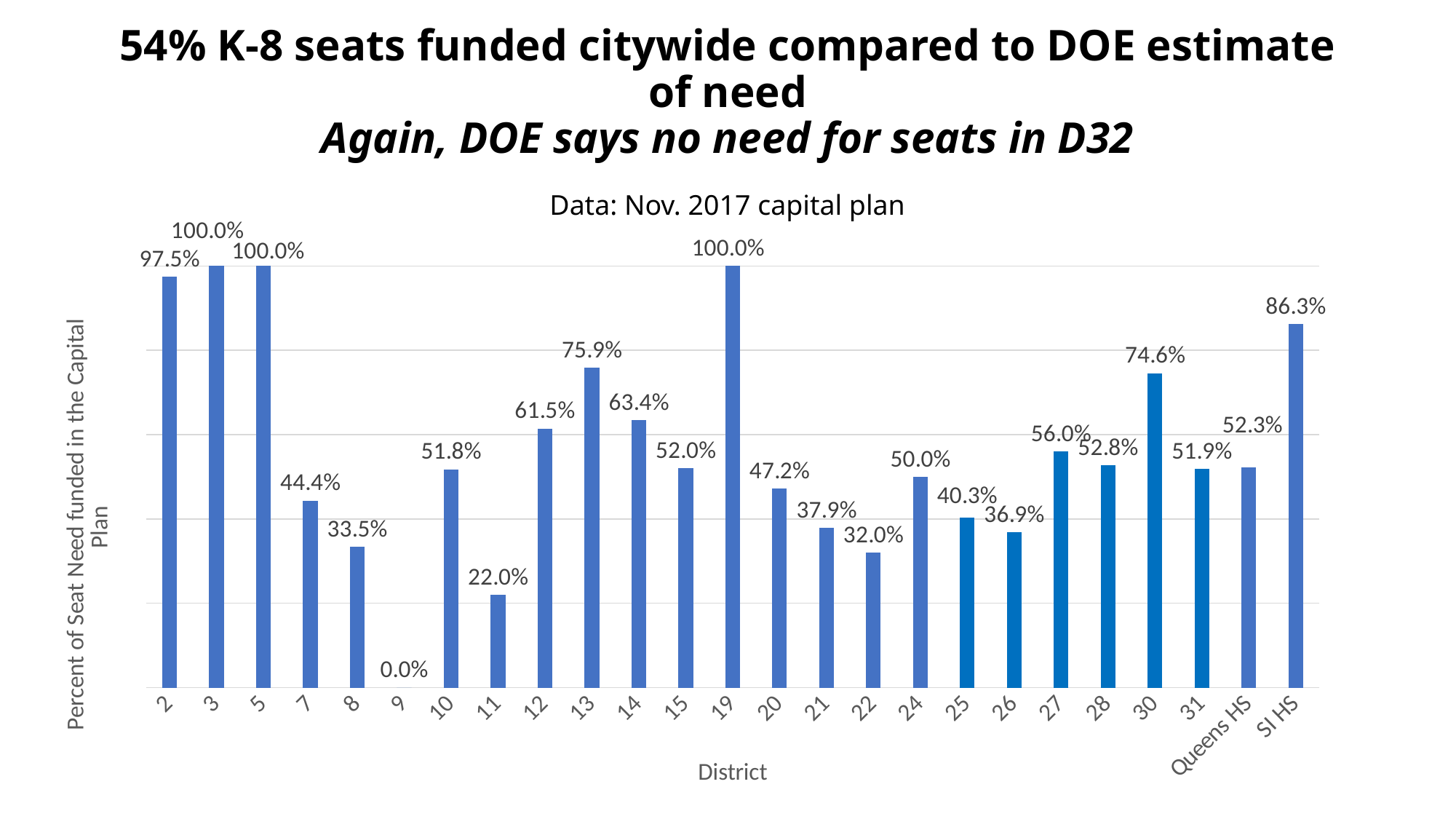
Which district has the lowest percent of seat need funded? 9 Which has a higher value, district 13 or district 14? District 13 What is the highest value shown on the chart? 100.0% Which has a higher value, district 27 or district 28? District 27 What is the value for SI HS? 86.3% How many categories are shown on the x axis? 25 What is the difference between the values for SI HS and district 30? 11.7 percentage points What is the difference between the values for district 12 and district 10? 9.7 percentage points What type of chart is shown on the slide? Bar chart What is the value for Queens HS? 52.3% What is the value for district 11? 22.0% What is the value for district 13? 75.9%